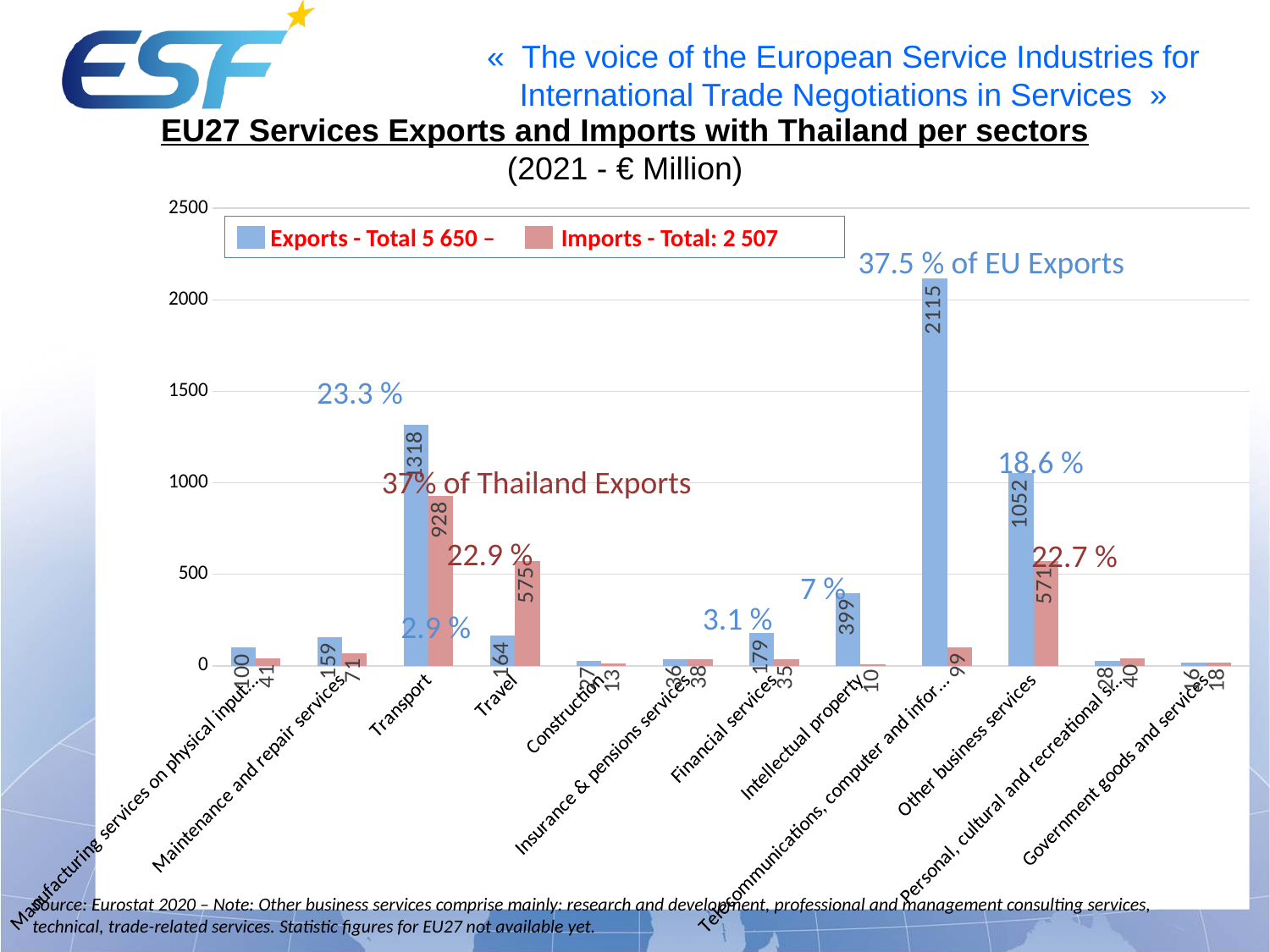
What is the Imports value for Travel? 575 Which sector has the highest Imports value? Transport For Travel, which is larger: Exports or Imports? Imports What is the Exports value for Transport? 1318 What is the difference between Exports and Imports for Transport? 390 Is the Exports value for Intellectual property greater or less than 500? less What is the Exports value for Other business services? 1052 Which sector has the lowest Exports value? Government goods and services What kind of chart is shown on the slide? Bar chart How many series does the legend list? 2 Which sector has the highest Exports value? Telecommunications, computer and infor... How many sectors are shown on the x axis? 12